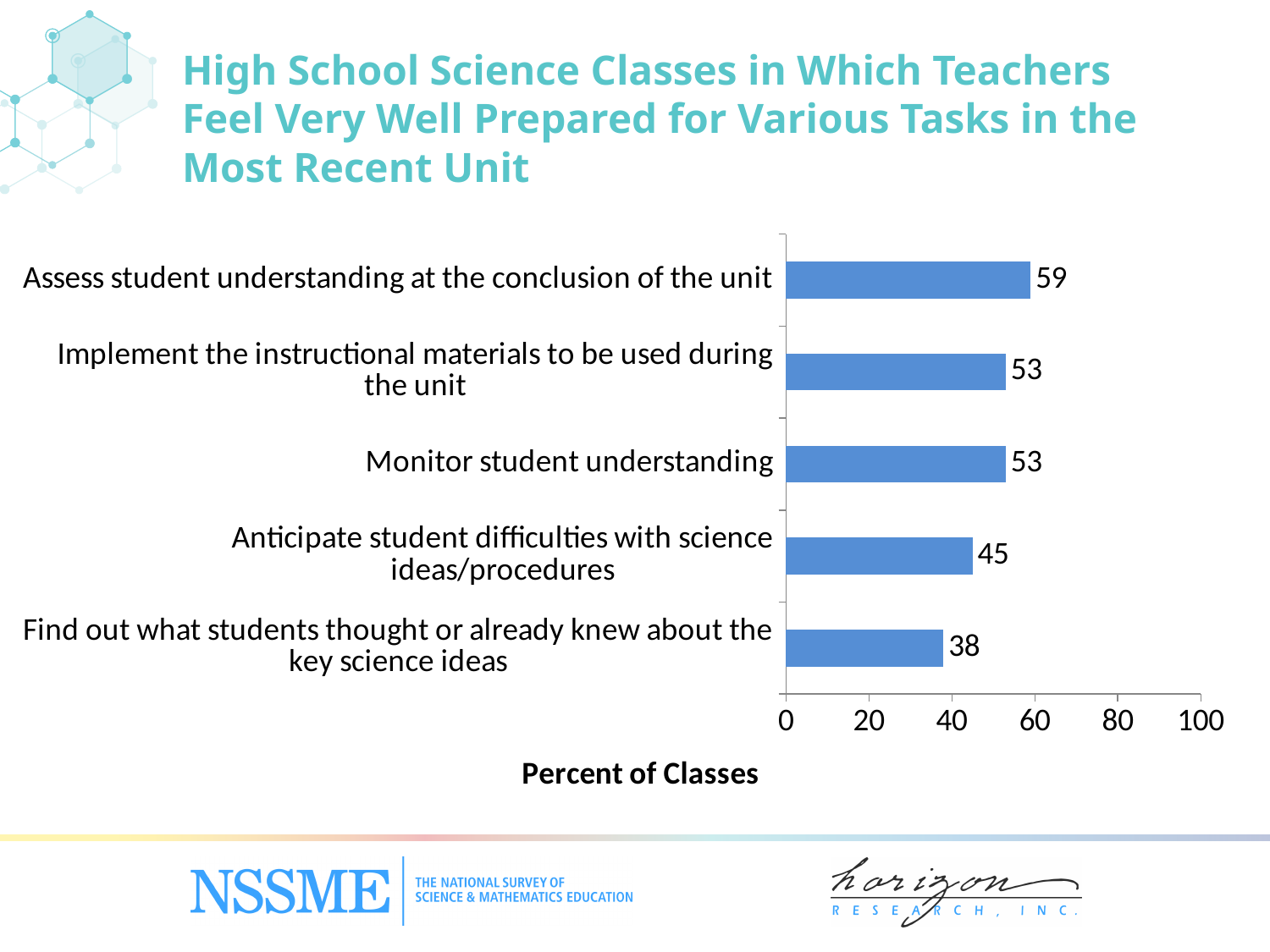
How many tasks (categories) are shown in the chart? 5 Is the value for "Implement the instructional materials to be used during the unit" greater or less than 40? greater Which task has the highest percent of classes? Assess student understanding at the conclusion of the unit What is the value for "Assess student understanding at the conclusion of the unit"? 59 Which task has the lowest percent of classes? Find out what students thought or already knew about the key science ideas Which is larger: the value for "Monitor student understanding" or the value for "Anticipate student difficulties with science ideas/procedures"? Monitor student understanding What kind of chart is shown on the slide? bar chart What is the value for "Monitor student understanding"? 53 What is the label on the horizontal axis of the chart? Percent of Classes What is the value for "Anticipate student difficulties with science ideas/procedures"? 45 What is the difference between the values for "Assess student understanding at the conclusion of the unit" and "Find out what students thought or already knew about the key science ideas"? 21 What is the value for "Find out what students thought or already knew about the key science ideas"? 38